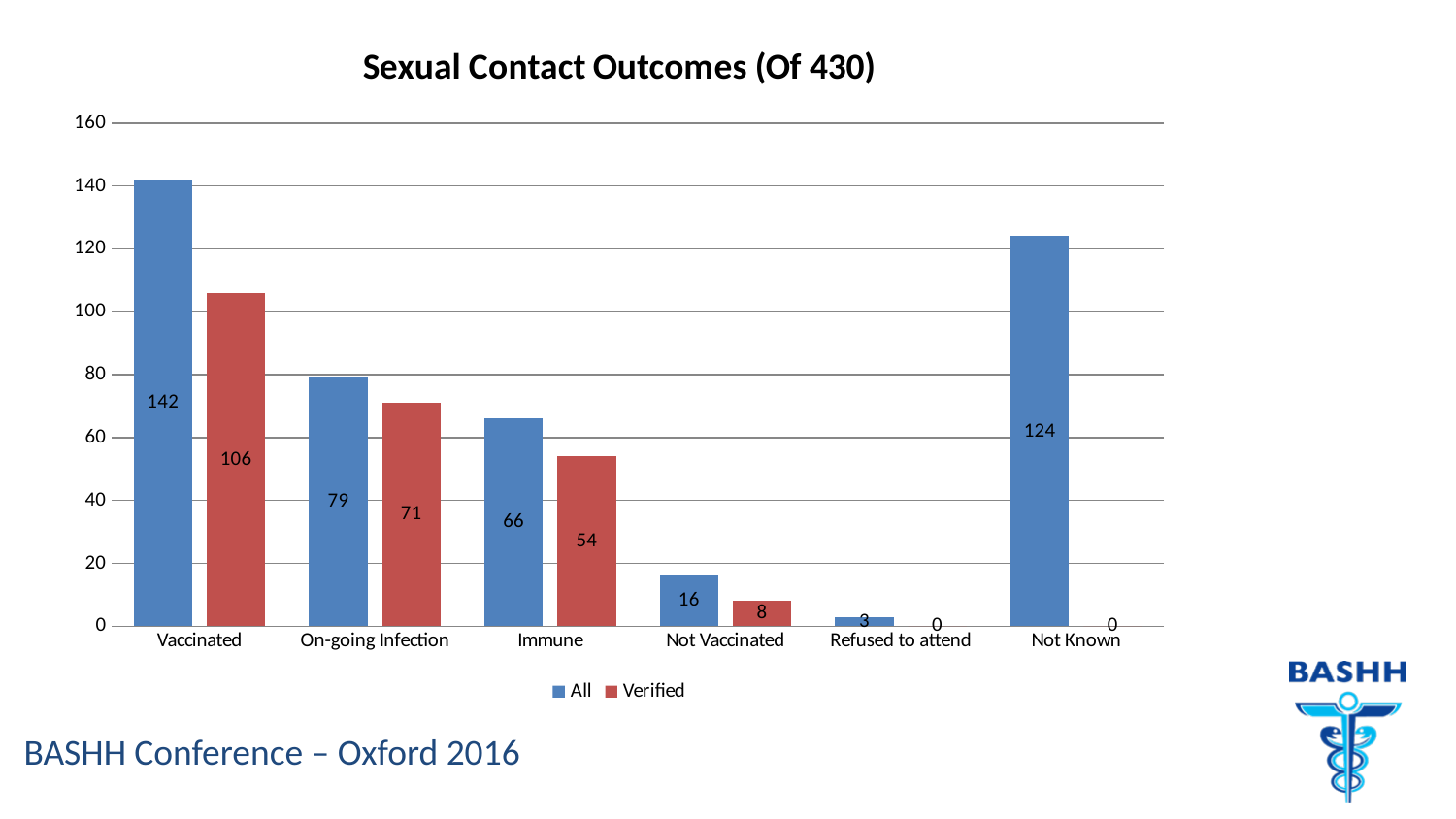
Which category has the lowest 'All' value? Refused to attend What kind of chart is shown on the slide? Bar chart What is the 'All' value for Vaccinated? 142 Is the 'All' value for Not Known greater or less than 120? greater How many series does the legend list? 2 What is the 'Verified' value for Not Known? 0 Which category has the highest 'All' value? Vaccinated Which is larger, the 'All' value for Immune or the 'All' value for Not Known? Not Known What is the title of the chart? Sexual Contact Outcomes (Of 430) How many categories are shown on the x axis? 6 What is the difference between the 'All' and 'Verified' values for Vaccinated? 36 What is the 'Verified' value for On-going Infection? 71